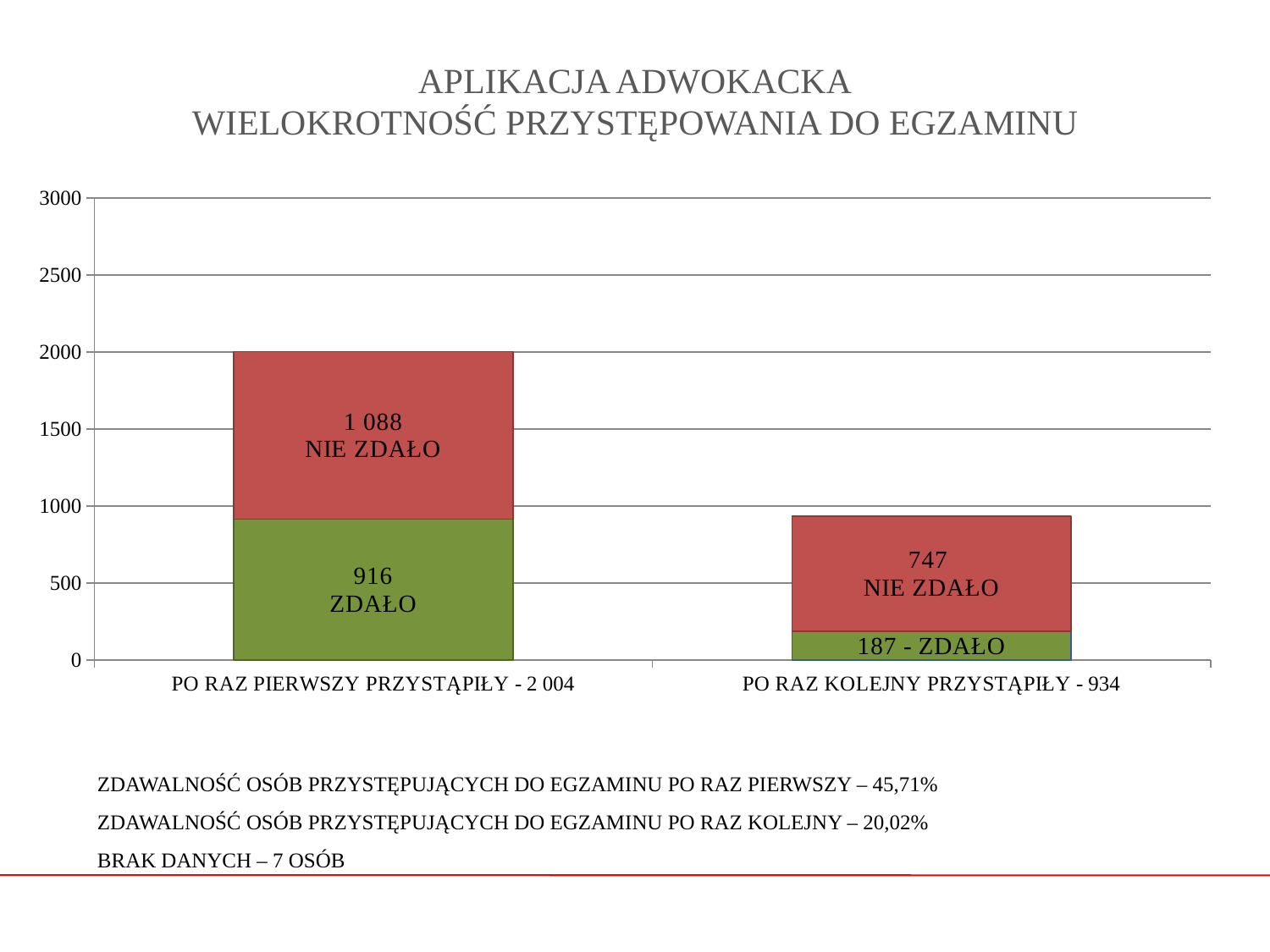
What is the difference between the number who failed and the number who passed among first-time takers (PO RAZ PIERWSZY PRZYSTĄPIŁY)? 172 What colour represents the ZDAŁO (passed) segment in the bars? green Is the total bar for PO RAZ KOLEJNY PRZYSTĄPIŁY greater or less than 1000? less What is the total of the stacked bar for PO RAZ PIERWSZY PRZYSTĄPIŁY? 2 004 How many people passed (ZDAŁO) among those who took the exam for the first time (PO RAZ PIERWSZY PRZYSTĄPIŁY)? 916 What kind of chart is shown on the slide? stacked bar chart How many people failed (NIE ZDAŁO) among those who took the exam for the first time (PO RAZ PIERWSZY PRZYSTĄPIŁY)? 1 088 How many categories are plotted on the x axis? 2 How many people failed (NIE ZDAŁO) among those who took the exam again (PO RAZ KOLEJNY PRZYSTĄPIŁY)? 747 What is the total of the stacked bar for PO RAZ KOLEJNY PRZYSTĄPIŁY? 934 Which category has the higher total bar, PO RAZ PIERWSZY PRZYSTĄPIŁY or PO RAZ KOLEJNY PRZYSTĄPIŁY? PO RAZ PIERWSZY PRZYSTĄPIŁY How many people passed (ZDAŁO) among those who took the exam again (PO RAZ KOLEJNY PRZYSTĄPIŁY)? 187